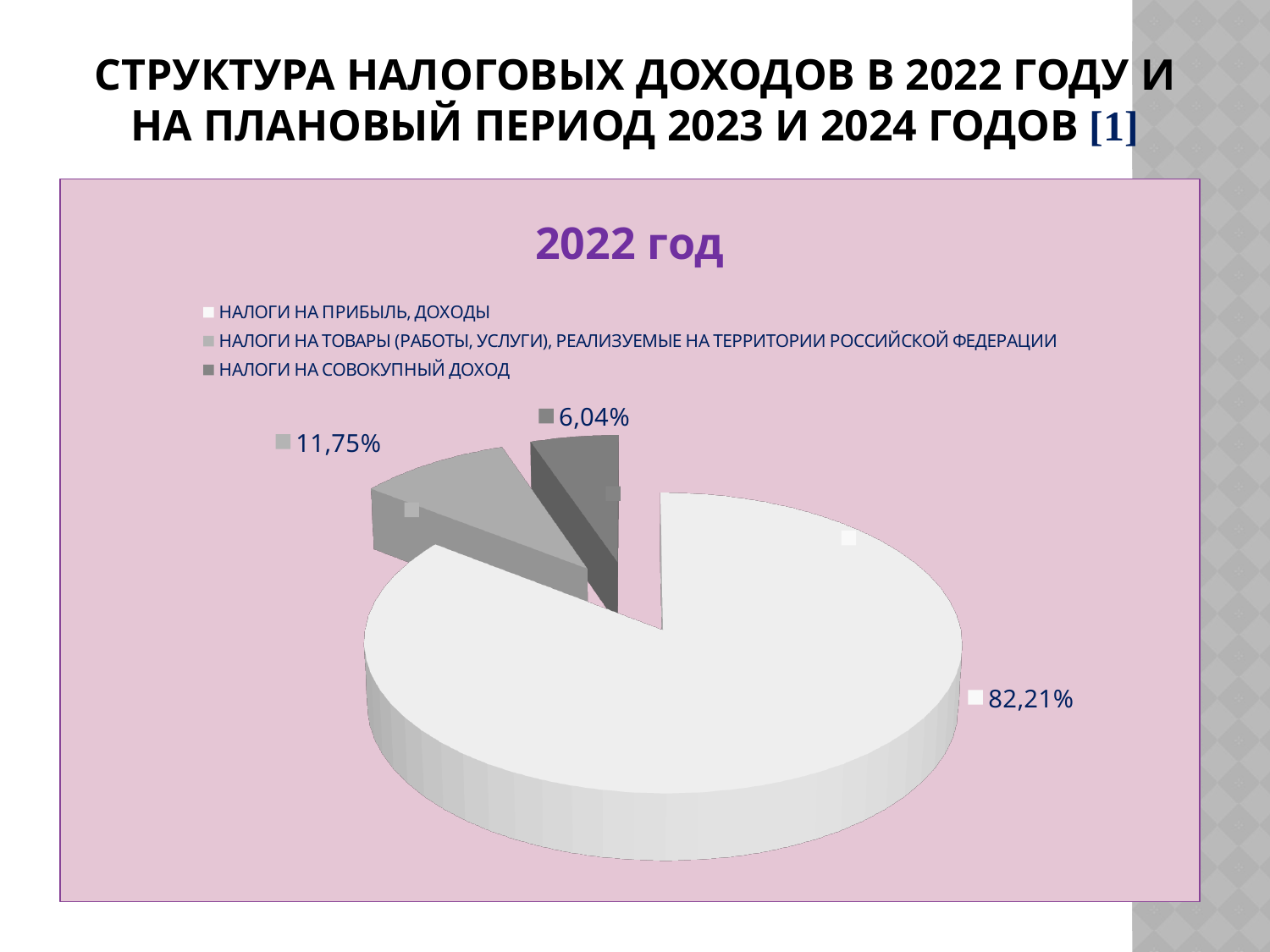
Which category has the largest share of the pie? НАЛОГИ НА ПРИБЫЛЬ, ДОХОДЫ What is the difference in percentage points between the share of НАЛОГИ НА ТОВАРЫ (РАБОТЫ, УСЛУГИ), РЕАЛИЗУЕМЫЕ НА ТЕРРИТОРИИ РОССИЙСКОЙ ФЕДЕРАЦИИ and НАЛОГИ НА СОВОКУПНЫЙ ДОХОД? 5,71 Which category has the smallest share of the pie? НАЛОГИ НА СОВОКУПНЫЙ ДОХОД Which is larger: the share of НАЛОГИ НА ТОВАРЫ (РАБОТЫ, УСЛУГИ), РЕАЛИЗУЕМЫЕ НА ТЕРРИТОРИИ РОССИЙСКОЙ ФЕДЕРАЦИИ or the share of НАЛОГИ НА СОВОКУПНЫЙ ДОХОД? НАЛОГИ НА ТОВАРЫ (РАБОТЫ, УСЛУГИ), РЕАЛИЗУЕМЫЕ НА ТЕРРИТОРИИ РОССИЙСКОЙ ФЕДЕРАЦИИ What kind of chart is shown on the slide? pie chart Which legend entry is shown in white on the pie chart? НАЛОГИ НА ПРИБЫЛЬ, ДОХОДЫ What is the title of the chart? 2022 год What share of the pie is НАЛОГИ НА СОВОКУПНЫЙ ДОХОД? 6,04% What share of the pie is НАЛОГИ НА ПРИБЫЛЬ, ДОХОДЫ? 82,21% What share of the pie is НАЛОГИ НА ТОВАРЫ (РАБОТЫ, УСЛУГИ), РЕАЛИЗУЕМЫЕ НА ТЕРРИТОРИИ РОССИЙСКОЙ ФЕДЕРАЦИИ? 11,75% How many entries does the legend list? 3 How many slices does the pie chart have? 3